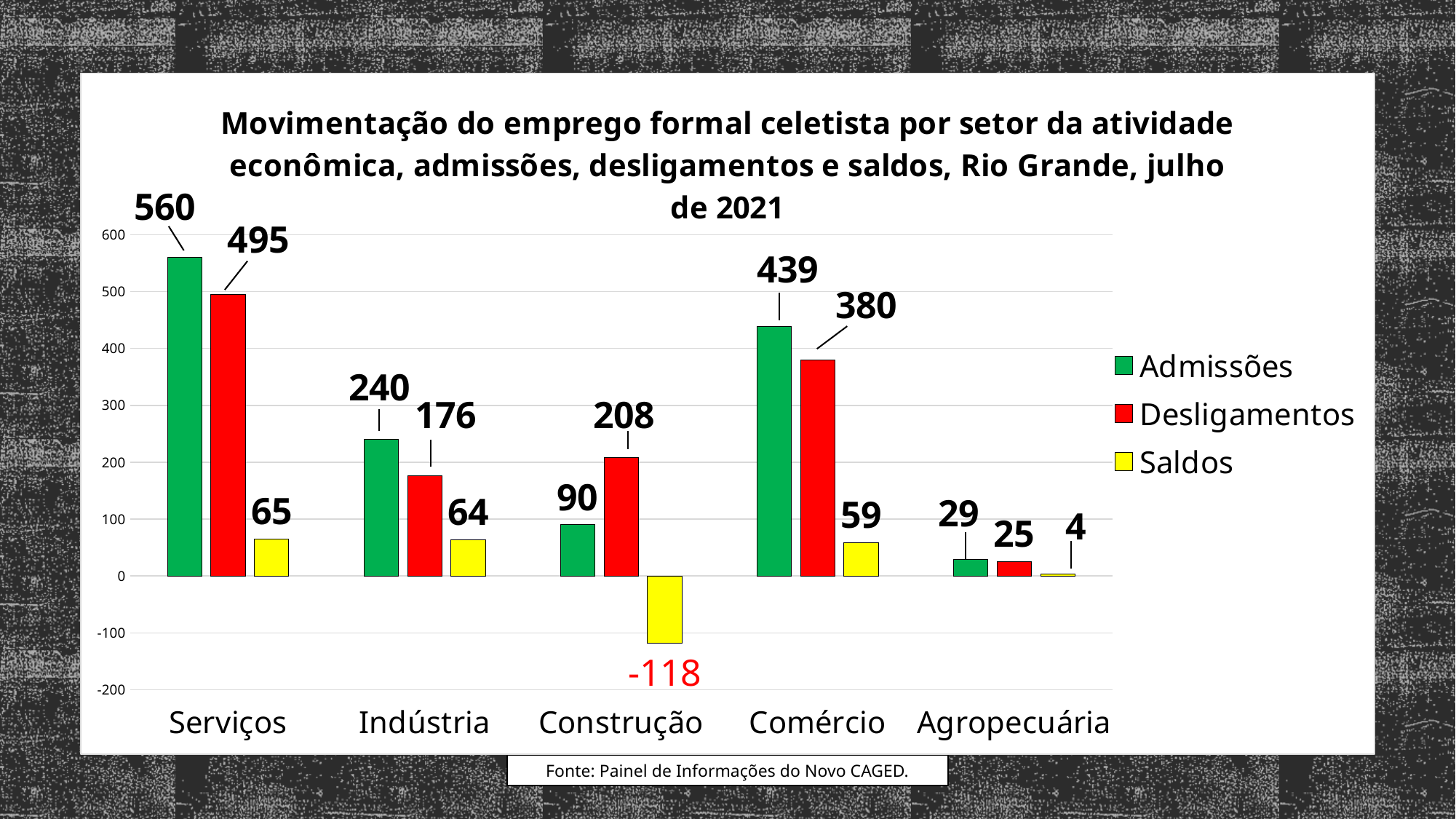
What kind of chart is shown on the slide? Bar chart What is the value of Admissões for Serviços? 560 What is the value of Desligamentos for Comércio? 380 How many series does the legend list? 3 Which sector has the highest value of Admissões? Serviços What is the value of Saldos for Construção? -118 What colour represents the Saldos series in the legend? Yellow What is the difference between Admissões and Desligamentos for Indústria? 64 Which sector has the lowest value of Desligamentos? Agropecuária What is the value of Saldos for Agropecuária? 4 How many sectors are shown on the x axis? 5 Which is larger for Construção: Admissões or Desligamentos? Desligamentos